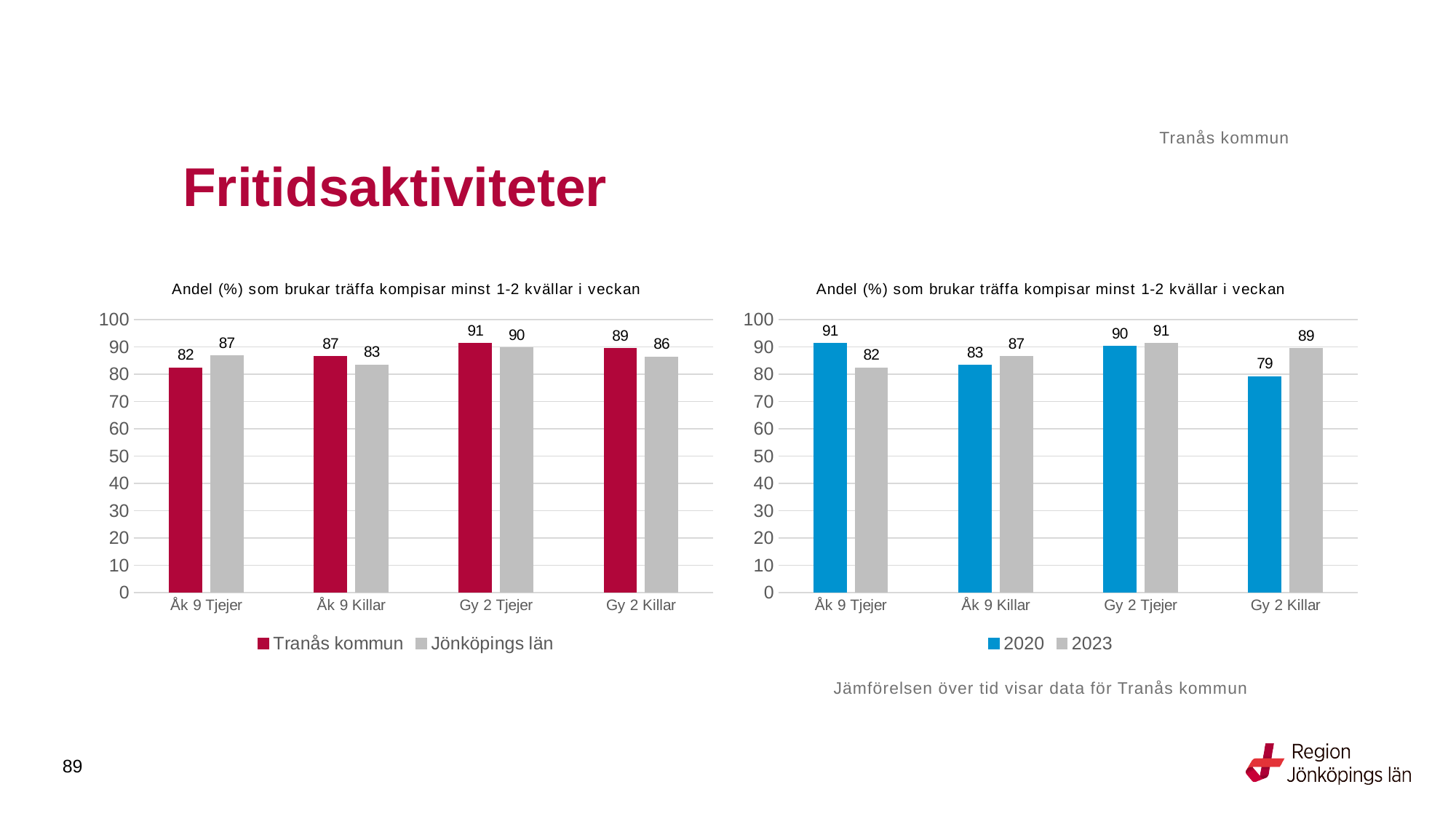
In the right chart, which category has the lowest value for 2020? Gy 2 Killar In the left chart, what is the value for Tranås kommun for Åk 9 Tjejer? 82 In the left chart, what is the value for Jönköpings län for Gy 2 Killar? 86 How many categories are shown on the x axis of the left chart? 4 In the left chart, which category has the highest value for Tranås kommun? Gy 2 Tjejer In the right chart, what is the difference between 2020 and 2023 for Gy 2 Killar? 10 In the left chart, what is the difference between Tranås kommun and Jönköpings län for Åk 9 Killar? 4 In the right chart, how many series does the legend list? 2 What kind of chart is the right chart? Bar chart In the right chart, what is the value for 2023 for Åk 9 Killar? 87 In the left chart, which is larger for Åk 9 Tjejer: Tranås kommun or Jönköpings län? Jönköpings län In the right chart, what is the value for 2020 for Gy 2 Killar? 79